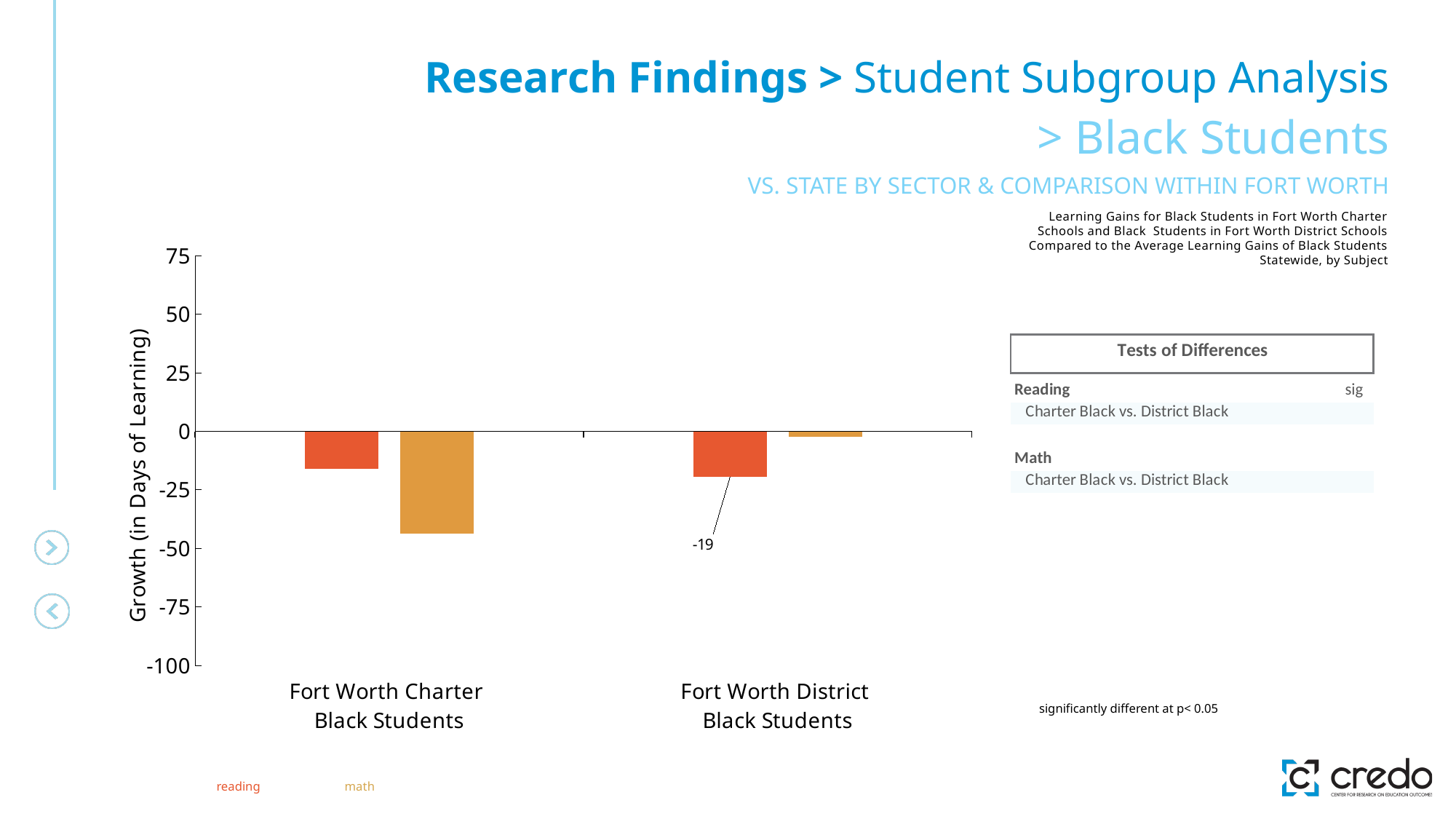
Which series does the legend show in the red-orange colour? reading What is the label on the y axis of the chart? Growth (in Days of Learning) How many student groups (categories) are shown on the x axis? 2 For Fort Worth Charter Black Students, which is larger, the reading value or the math value? reading Which student group has the lowest math value? Fort Worth Charter Black Students Is the math value for Fort Worth Charter Black Students greater or less than -25? less Is the math value for Fort Worth District Black Students greater or less than -25? greater What kind of chart is shown on the slide? bar chart What is the reading value for Fort Worth District Black Students? -19 Is the reading value for Fort Worth Charter Black Students greater or less than -25? greater Which student group has the highest math value? Fort Worth District Black Students How many series does the legend list? 2